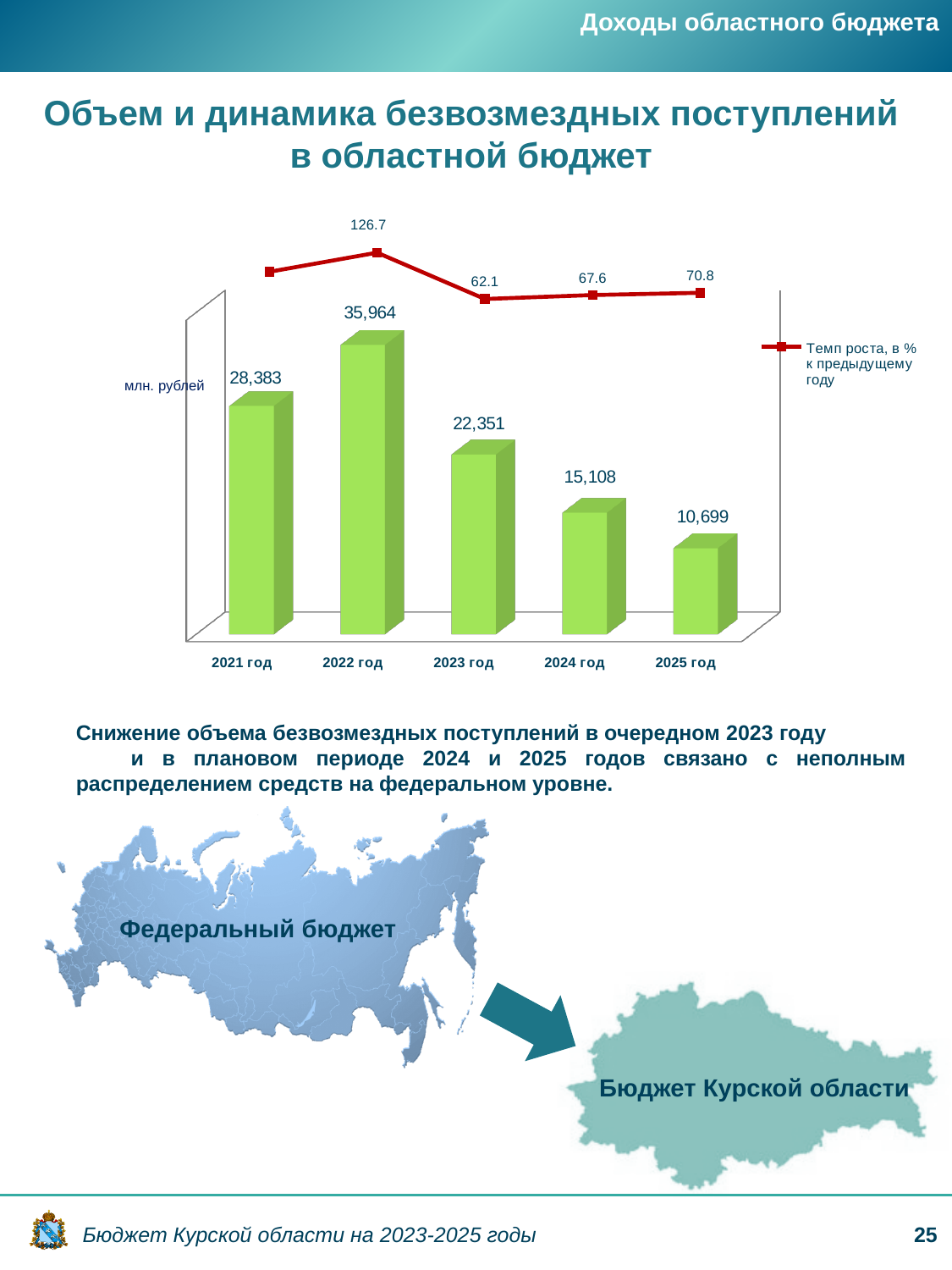
Do the bar values rise or fall from 2022 год to 2025 год? fall What is the growth rate (Темп роста) shown for 2025 год? 70.8 What kind of chart is used to show the values in млн. рублей? bar chart Which year has the highest bar value? 2022 год What is the value of the bar for 2025 год? 10,699 What is the growth rate (Темп роста) shown for 2023 год? 62.1 How many years are shown on the x axis of the chart? 5 What is the unit label shown next to the bars? млн. рублей Which year has the lowest bar value? 2025 год Which is larger, the bar value for 2021 год or for 2024 год? 2021 год What is the value of the bar for 2022 год? 35,964 What is the difference between the bar values for 2022 год and 2023 год? 13,613